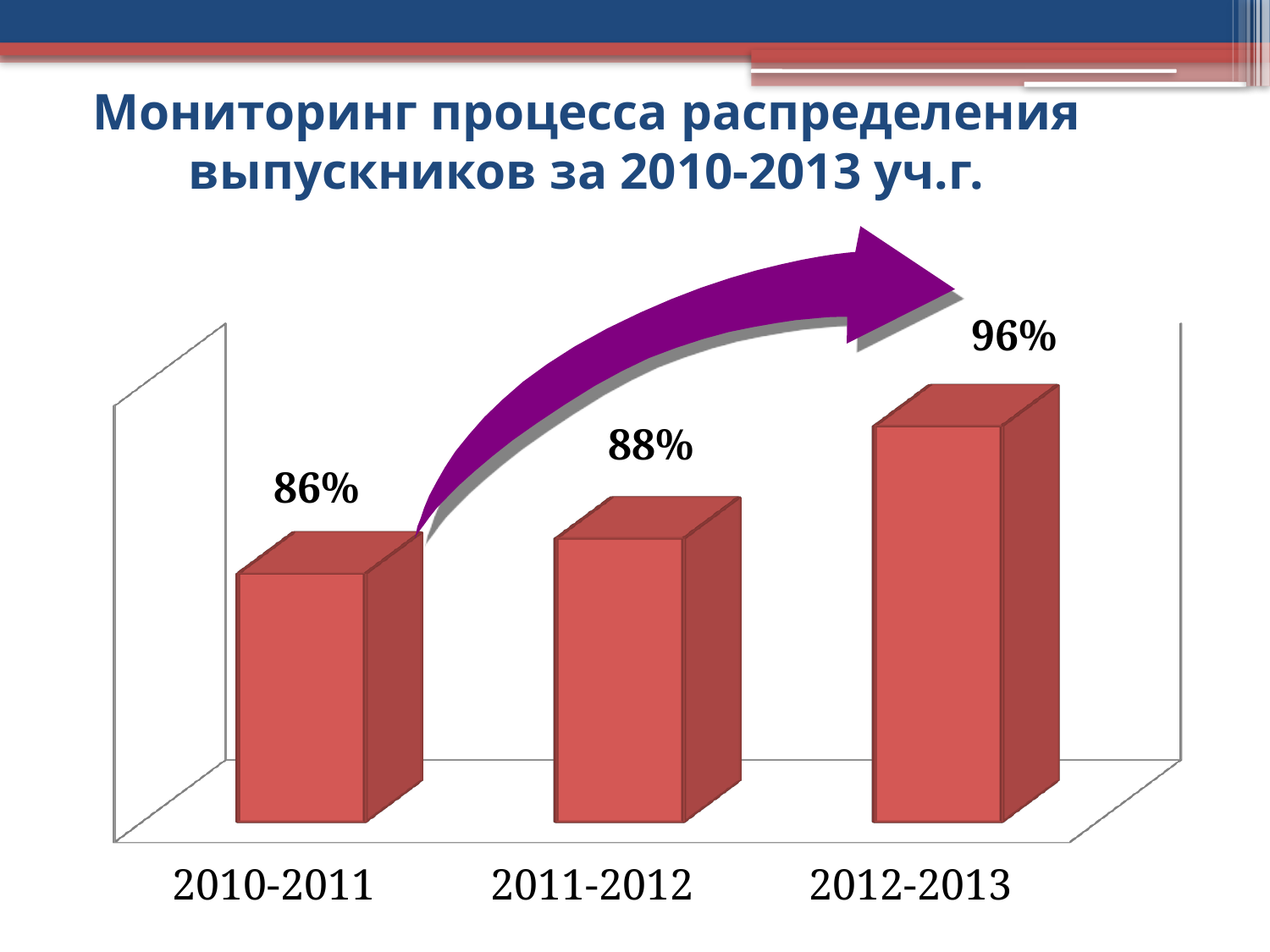
What is the value for 2010-2011? 86% What is the difference between the values for 2011-2012 and 2010-2011? 2% What kind of chart is shown on the slide? Bar chart What is the difference between the values for 2012-2013 and 2010-2011? 10% What is the value for 2011-2012? 88% What is the value for 2012-2013? 96% How many academic years are shown on the chart? 3 What is the title of the slide? Мониторинг процесса распределения выпускников за 2010-2013 уч.г. Which academic year has the highest value? 2012-2013 Which academic year has the lowest value? 2010-2011 Which is larger, the value for 2011-2012 or the value for 2012-2013? 2012-2013 Do the values rise or fall from 2010-2011 to 2012-2013? Rise